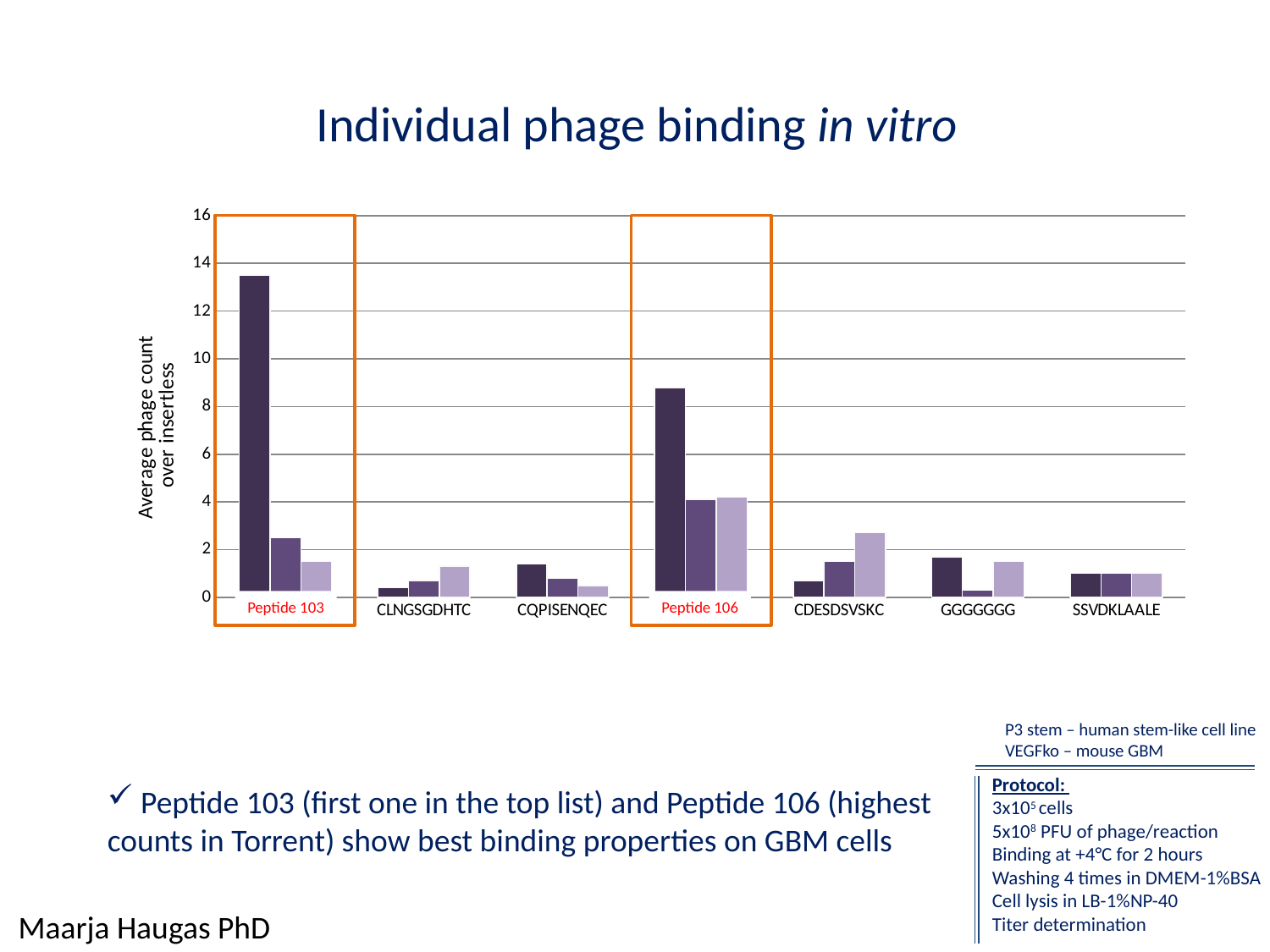
How many categories are shown along the x axis of the chart? 7 Is the value of the tallest bar for CDESDSVSKC greater or less than 2? greater Is the value of the tallest bar for Peptide 103 greater or less than 12? greater What kind of chart is shown on the slide? bar chart Is the value of the tallest bar for GGGGGGG greater or less than 2? less How many bars are plotted for each category in the chart? 3 Which has the taller dark-purple bar, Peptide 103 or Peptide 106? Peptide 103 Which category has the tallest bar in the chart? Peptide 103 What is the title of the chart on the slide? Individual phage binding in vitro Which has the taller light-purple bar, CDESDSVSKC or GGGGGGG? CDESDSVSKC What is the label on the y axis of the chart? Average phage count over insertless